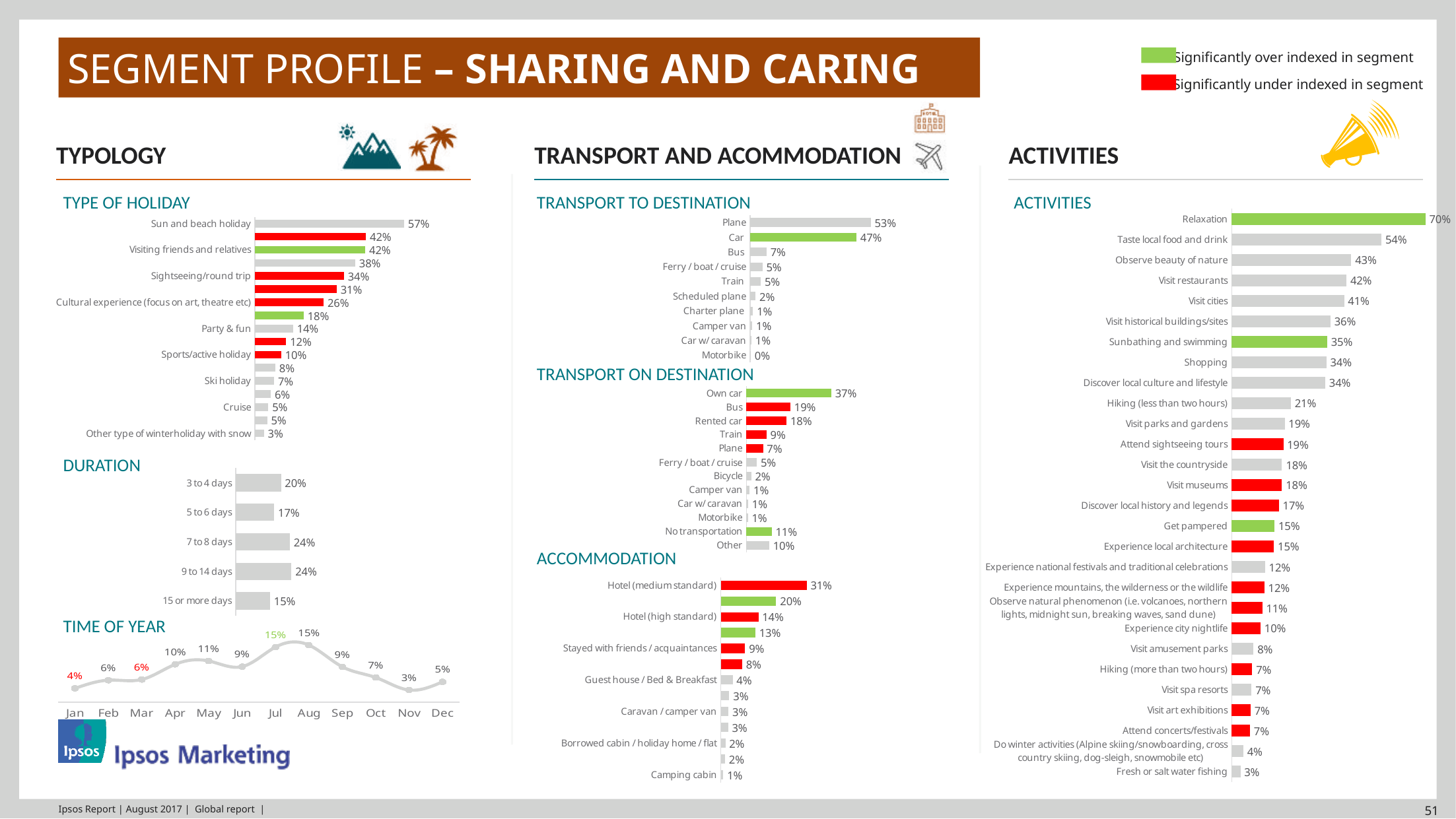
In the Transport to Destination chart, what is the value for Car? 47% What kind of chart is the Time of Year chart? Line chart In the Activities chart, which activity has the highest value? Relaxation In the Duration chart, which duration has the lowest value? 15 or more days In the Accommodation chart, which is larger: Hotel (medium standard) or Hotel (high standard)? Hotel (medium standard) In the Time of Year chart, which month has the lowest value? Nov In the Transport on Destination chart, what is the difference between Own car and Bus? 18% In the Activities chart, what is the value for Sunbathing and swimming? 35% In the Time of Year chart, how many months are plotted? 12 In the Transport to Destination chart, what is the value for Motorbike? 0% In the Type of Holiday chart, what is the value for Sun and beach holiday? 57% In the Duration chart, what is the value for 15 or more days? 15%